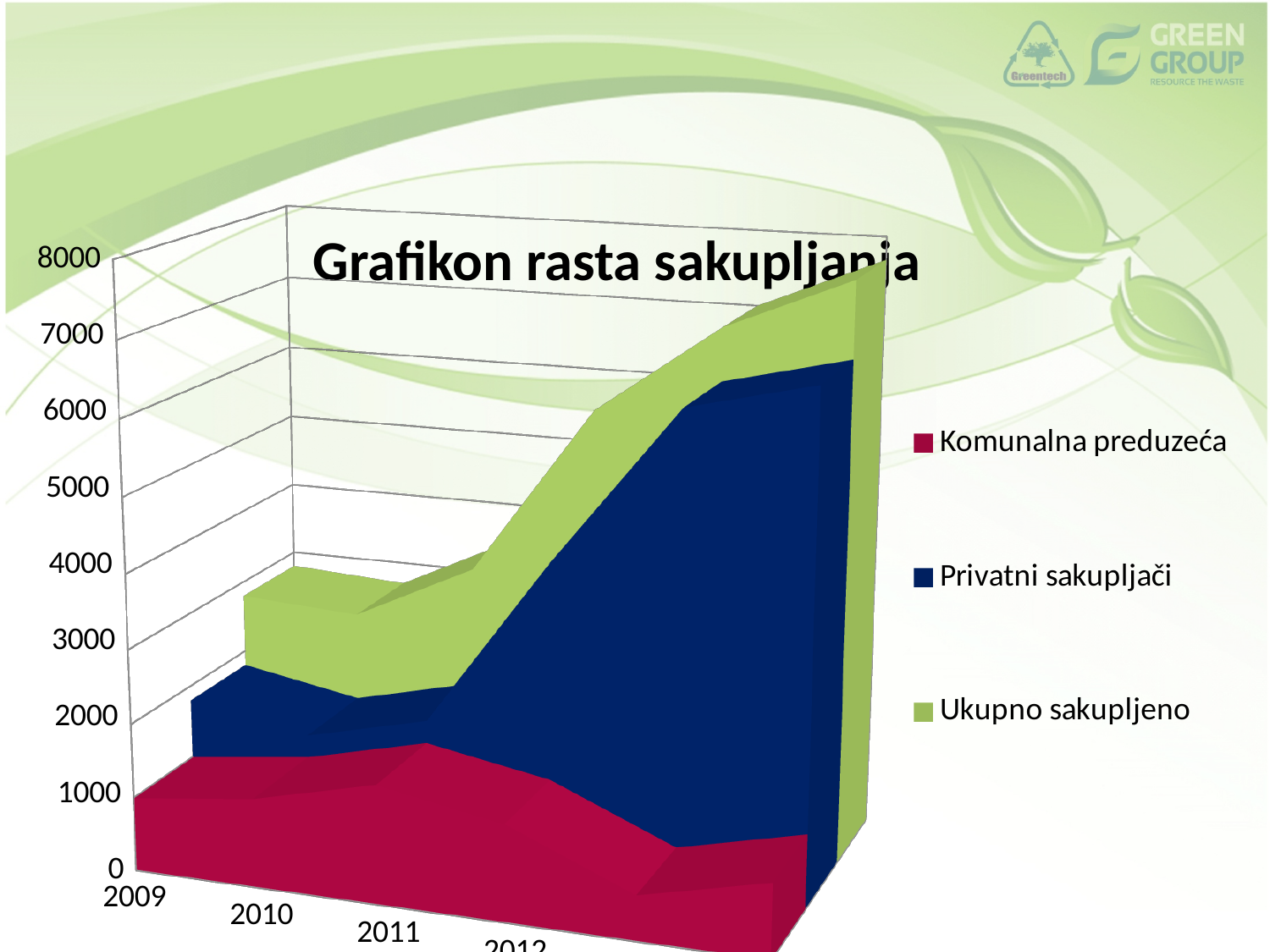
Is the value for Ukupno sakupljeno at the last year shown greater or less than 6000? greater Is the value for Komunalna preduzeća in 2009 greater or less than 3000? less Does the value for Ukupno sakupljeno rise or fall from 2009 to the last year shown? rise Which series is shown in green in the legend? Ukupno sakupljeno Is the value for Ukupno sakupljeno in 2009 greater or less than 2000? greater At the last year shown, which is larger: Privatni sakupljači or Komunalna preduzeća? Privatni sakupljači How many series does the legend list? 3 Does the value for Komunalna preduzeća rise or fall from 2011 to 2012? fall What kind of chart is shown on the slide? area chart Does the value for Privatni sakupljači rise or fall from 2010 to the last year shown? rise What is the title of the chart? Grafikon rasta sakupljanja